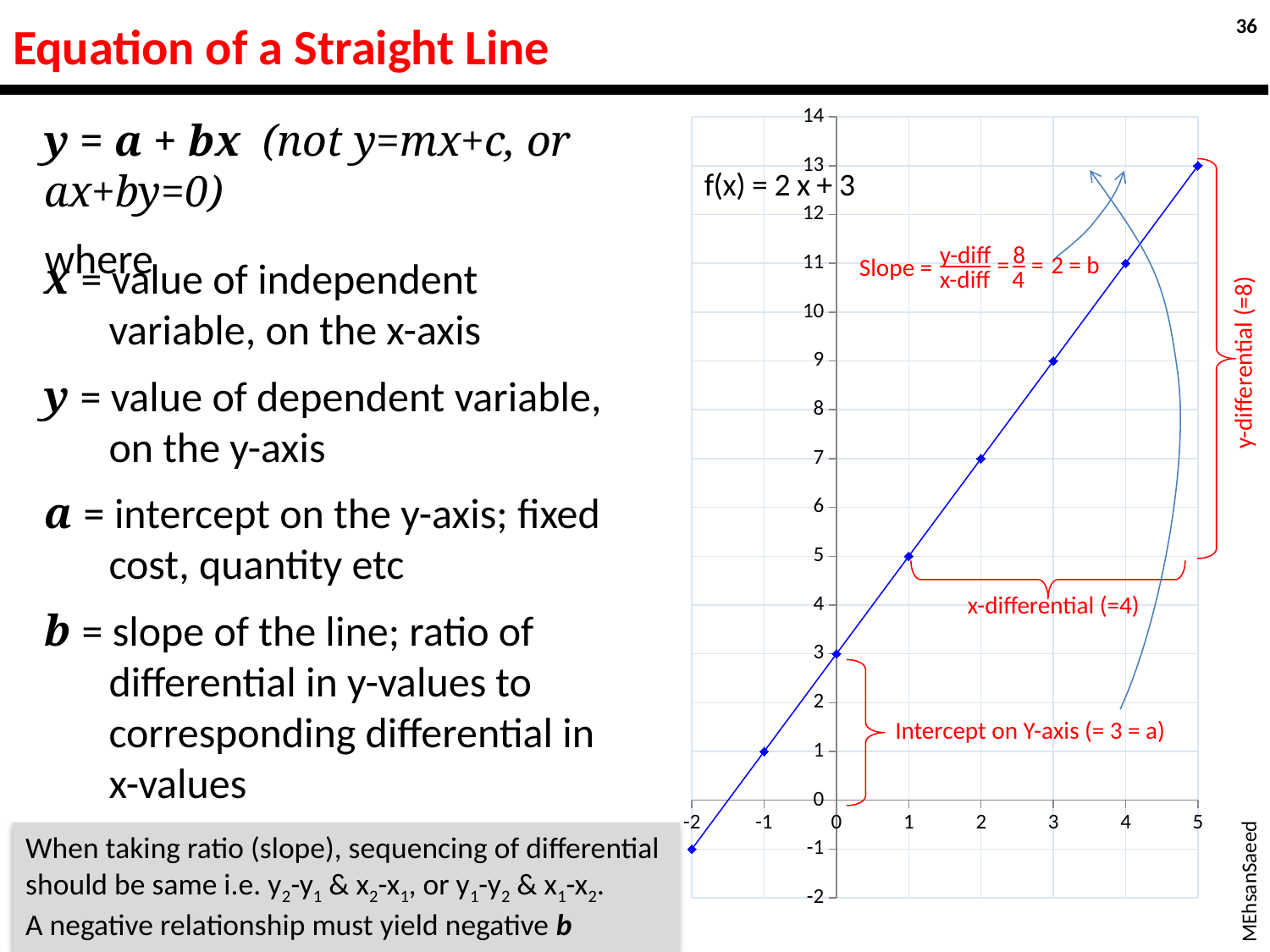
What function is plotted on the chart, as labelled on the slide? f(x) = 2 x + 3 What is the value of f(x) at x = -2 on the chart? -1 What is the value of f(x) at x = 0 on the chart? 3 What is the difference between f(x) at x = 5 and f(x) at x = 1? 8 According to the annotation on the chart, what is the intercept on the Y-axis? 3 How many data points are marked on the plotted line? 8 Do the y values rise or fall as x increases along the x axis? rise At which x value does the plotted line have its lowest y value? -2 What is the value of f(x) at x = 2 on the chart? 7 What is the value of f(x) at x = 5 on the chart? 13 At which x value does the plotted line reach its highest y value? 5 What type of chart is shown on the slide? line chart